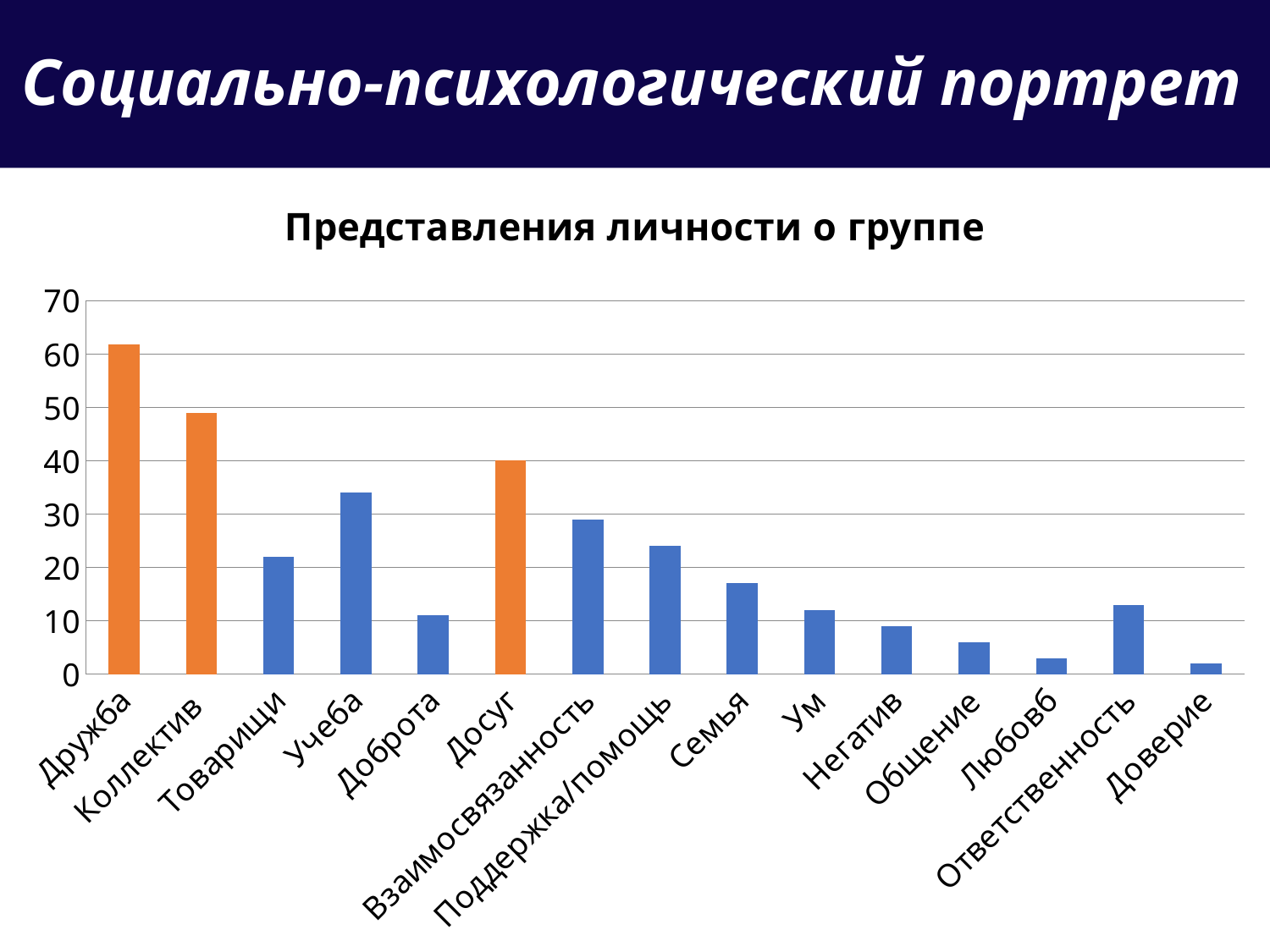
Which is larger, the value for Учеба or the value for Товарищи? Учеба Which is larger, the value for Ответственность or the value for Негатив? Ответственность How many categories are shown on the x axis of the chart? 15 Is the value for Учеба greater or less than 30? greater Which category has the highest value in the chart? Дружба How many bars in the chart are coloured orange? 3 Is the value for Дружба greater or less than 60? greater What is the title of the chart? Представления личности о группе What kind of chart is shown on the slide? bar chart Is the value for Семья greater or less than 20? less What is the value for Досуг? 40